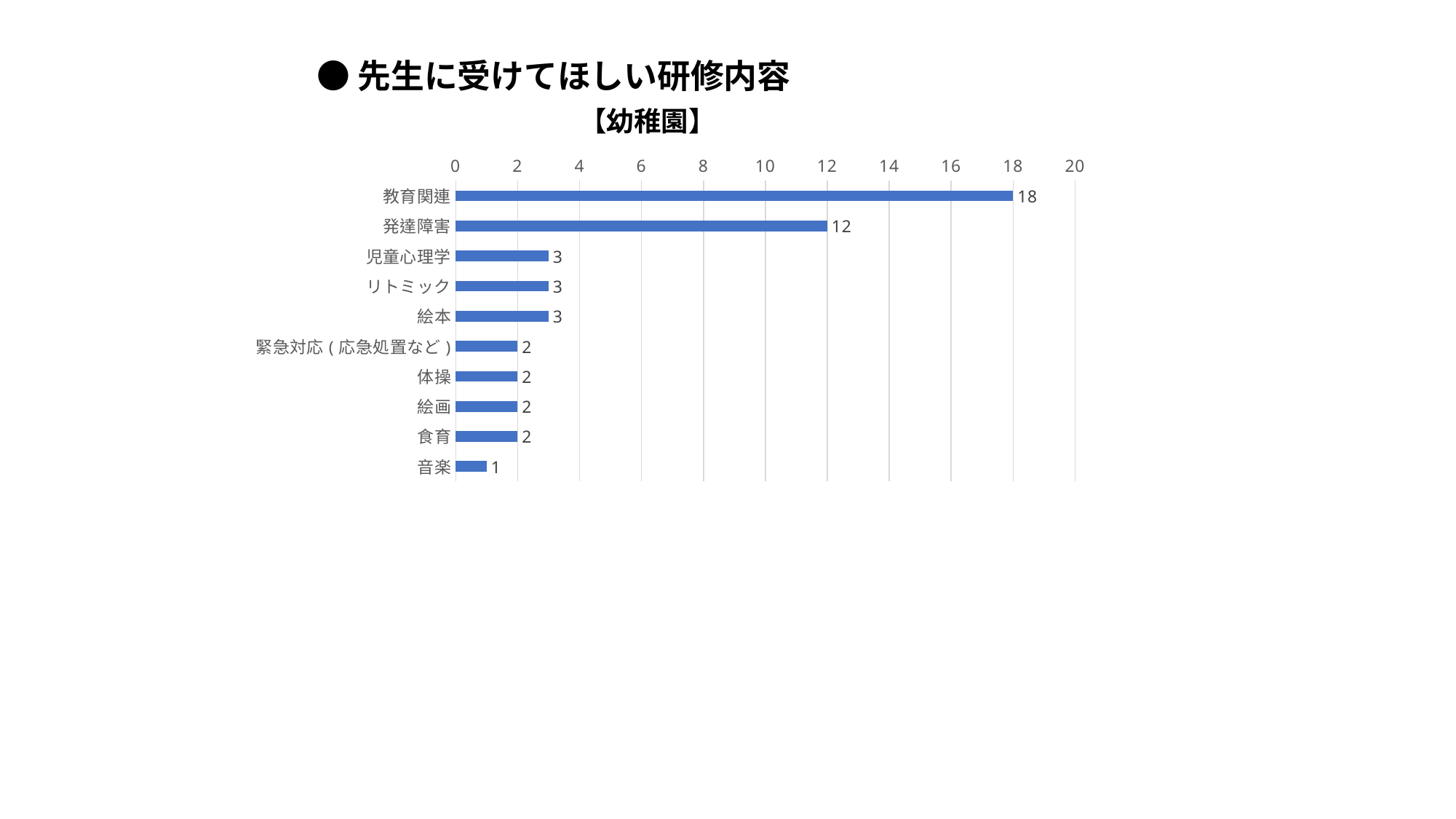
Is the value for 発達障害 greater or less than 10? greater Which category has the highest value? 教育関連 How many categories are shown in the chart? 10 What kind of chart is shown on the slide? Bar chart What is the value for 緊急対応(応急処置など)? 2 What is the subtitle shown above the chart in brackets? 【幼稚園】 What is the value for 発達障害? 12 Which category has the lowest value? 音楽 What is the value for 教育関連? 18 What is the difference between the values for 教育関連 and 発達障害? 6 What is the value for 音楽? 1 Which is larger, the value for 児童心理学 or the value for 体操? 児童心理学